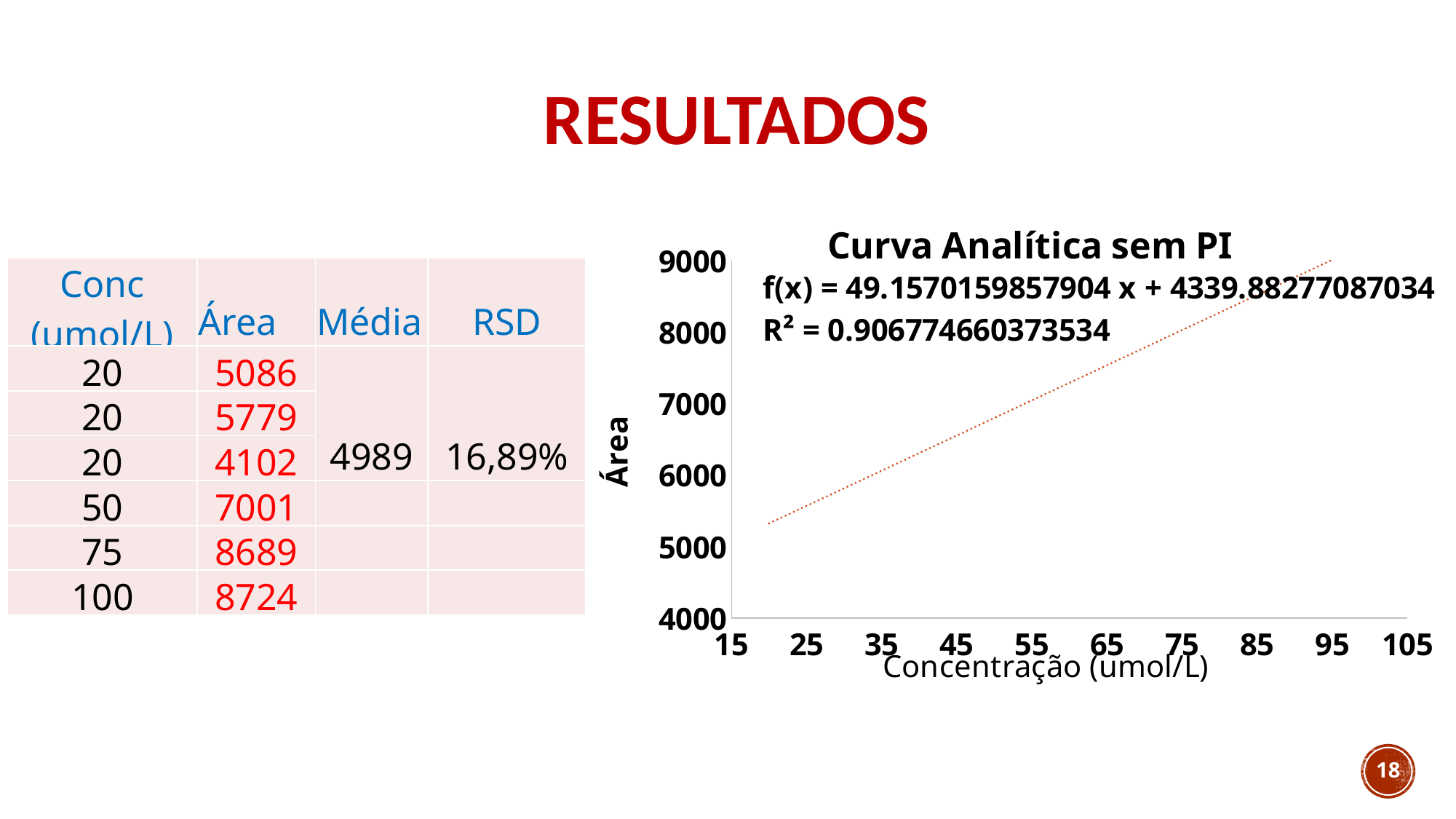
What is the equation of the trend line printed on the chart? f(x) = 49.1570159857904 x + 4339.88277087034 Is the value of the trend line at a concentration of 85 greater or less than 9000? less What is the highest value shown on the y axis of the chart? 9000 Does the trend line on the chart rise or fall as concentration increases? rise Is the value of the trend line at a concentration of 45 greater or less than 6000? greater Is the value of the trend line at a concentration of 25 greater or less than 6000? less What is the lowest value shown on the x axis of the chart? 15 What is the R² value printed on the chart? R² = 0.906774660373534 How many tick labels are shown on the x axis of the chart? 10 What is the title of the chart on the slide? Curva Analítica sem PI What is the label of the x axis of the chart? Concentração (umol/L)